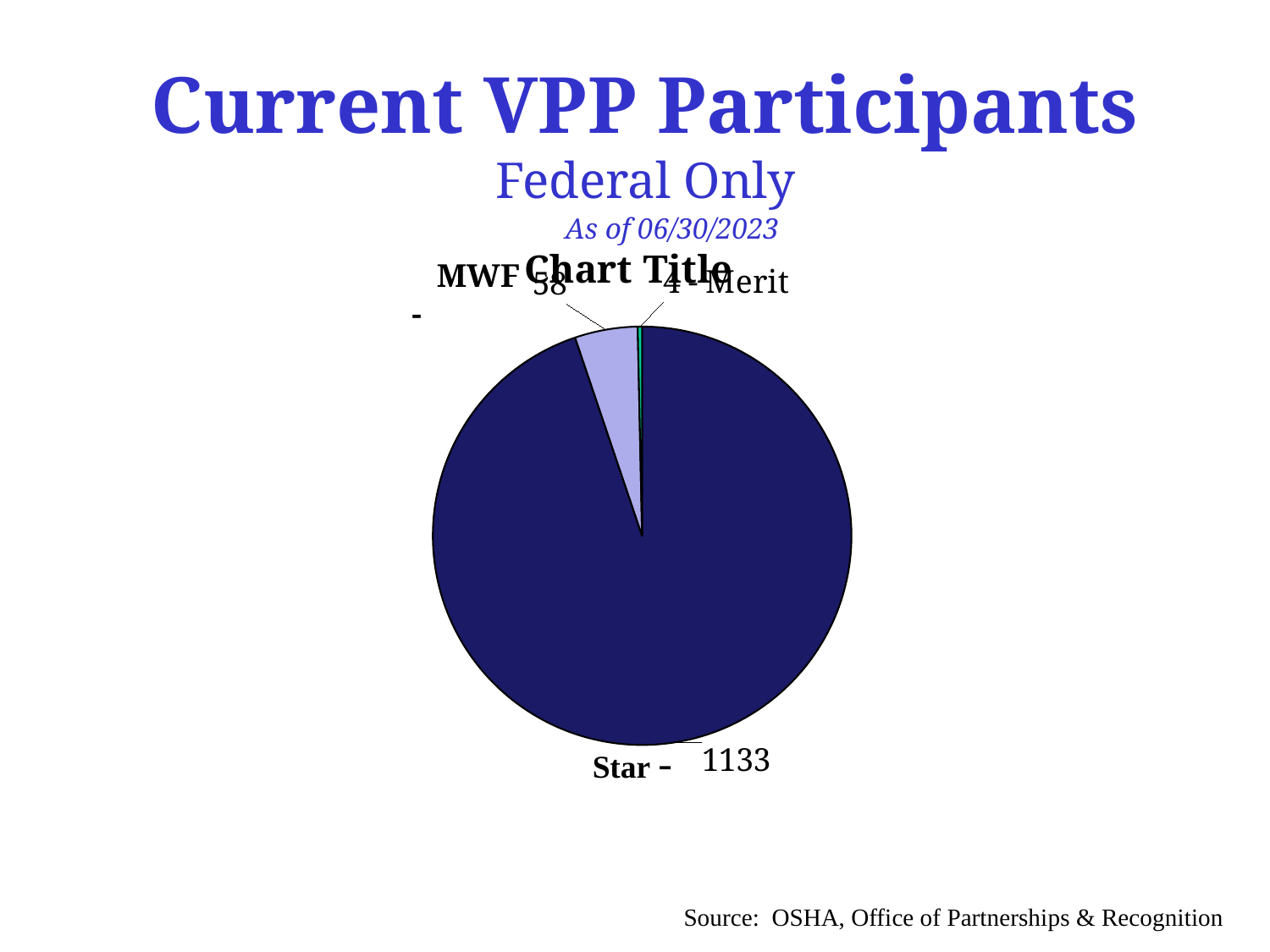
Which category has the largest slice of the pie chart? Star Which category has the smallest slice of the pie chart? Merit How many slices does the pie chart have? 3 What date is the data on the slide current as of? 06/30/2023 What is the value for Star in the pie chart? 1133 What is the difference between the MWF value and the Merit value? 54 What is the difference between the Star value and the MWF value? 1075 Which is larger, the value for MWF or the value for Merit? MWF What is the total of all three slices in the pie chart? 1195 What kind of chart is shown on the slide? pie chart What is the value for Merit in the pie chart? 4 What is the value for MWF in the pie chart? 58